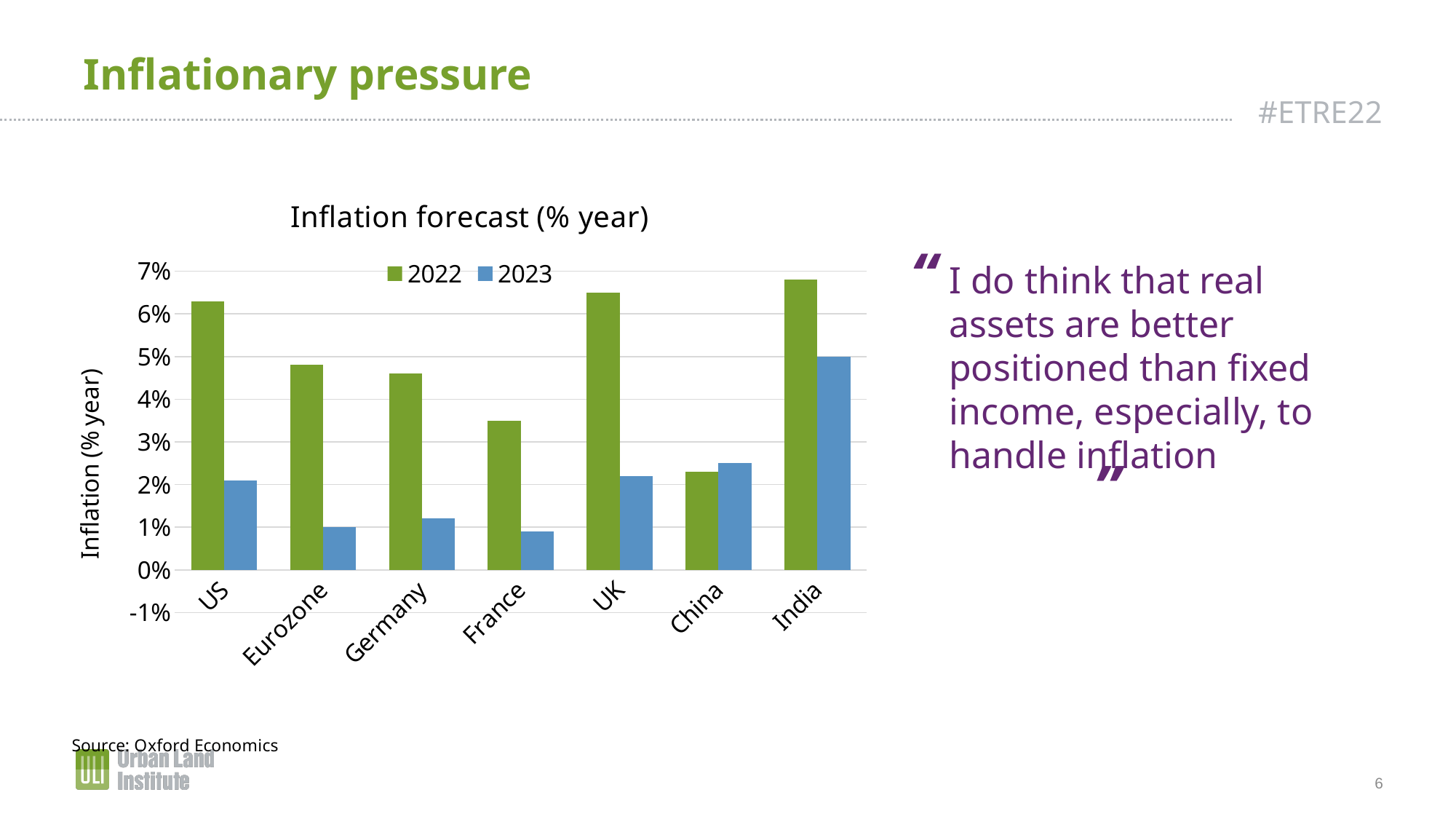
Is the 2022 inflation forecast for China greater or less than 3%? less What type of chart is shown on the slide? bar chart How many series does the legend list? 2 Is the 2022 inflation forecast for the US greater or less than 6%? greater Which country or region has the highest 2023 inflation forecast? India Is the 2022 inflation forecast for France greater or less than 4%? less Which series is shown in green in the legend? 2022 How many countries or regions are shown on the x axis? 7 What is the title of the chart? Inflation forecast (% year) Which country or region has the lowest 2022 inflation forecast? China For China, which is larger: the 2022 forecast or the 2023 forecast? 2023 Which country or region has the highest 2022 inflation forecast? India